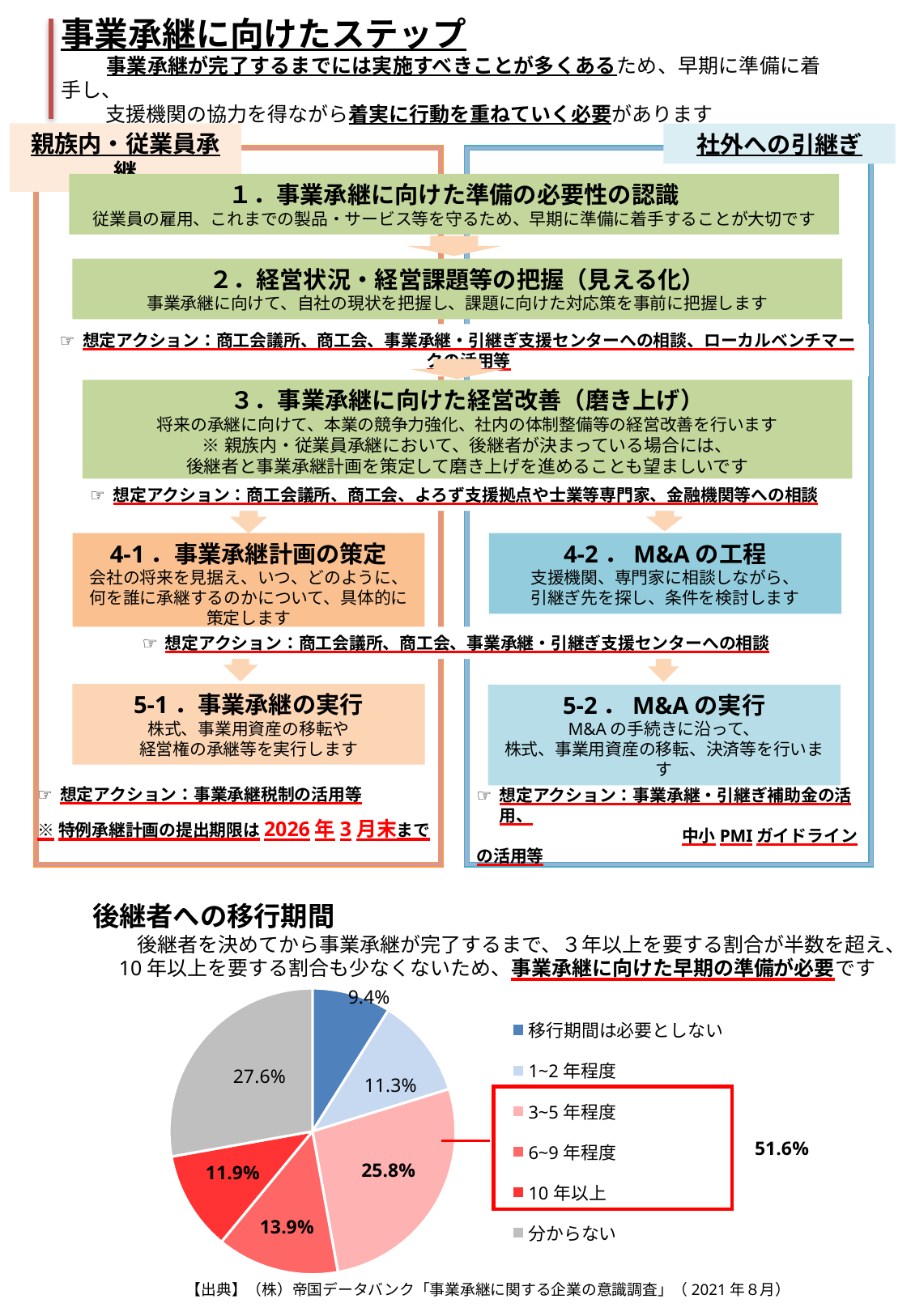
In the pie chart, what is the value for 3~5年程度? 25.8% In the pie chart, what is the value for 分からない? 27.6% Which category has the largest slice in the pie chart? 分からない Which category has the smallest slice in the pie chart? 移行期間は必要としない What is the combined share of the 3~5年程度, 6~9年程度 and 10年以上 slices, as printed next to the red box? 51.6% In the pie chart, what is the value for 10年以上? 11.9% What kind of chart is shown under the heading 後継者への移行期間? pie chart In the pie chart, what is the value for 移行期間は必要としない? 9.4% What colour is the 分からない slice in the pie chart? gray What is the difference between the 3~5年程度 slice and the 6~9年程度 slice in the pie chart? 11.9% How many categories does the pie chart's legend list? 6 Which is larger in the pie chart, 1~2年程度 or 6~9年程度? 6~9年程度